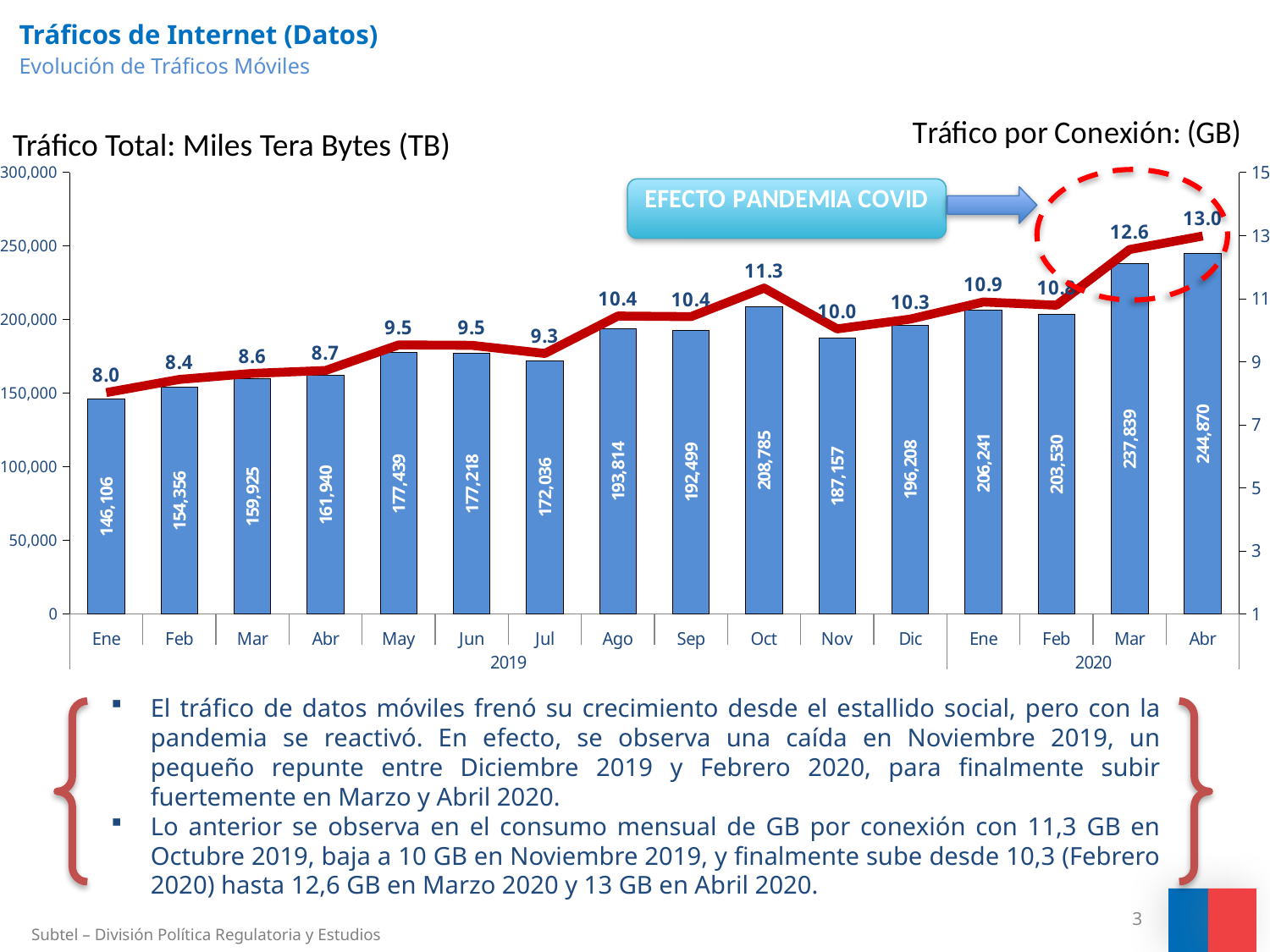
Does the Tráfico por Conexión line rise or fall from Ene 2019 to Abr 2019? Rise What is the difference in Tráfico por Conexión (GB) between Abr 2020 and Mar 2020? 0.4 How many months are shown on the x axis of the chart? 16 What kind of chart is used on the slide? Combined bar and line chart What is the Tráfico por Conexión (GB) value for Oct 2019? 11.3 What is the difference in Tráfico Total between Abr 2020 and Mar 2020? 7,031 What is the Tráfico Total value for Oct 2019? 208,785 Is the Tráfico Total value for Oct 2019 greater or less than 200,000? greater What is the Tráfico por Conexión (GB) value for Mar 2020? 12.6 Which month has the lowest Tráfico Total bar? Ene 2019 Which has the larger Tráfico Total, Nov 2019 or Dic 2019? Dic 2019 Which month has the highest Tráfico Total bar? Abr 2020